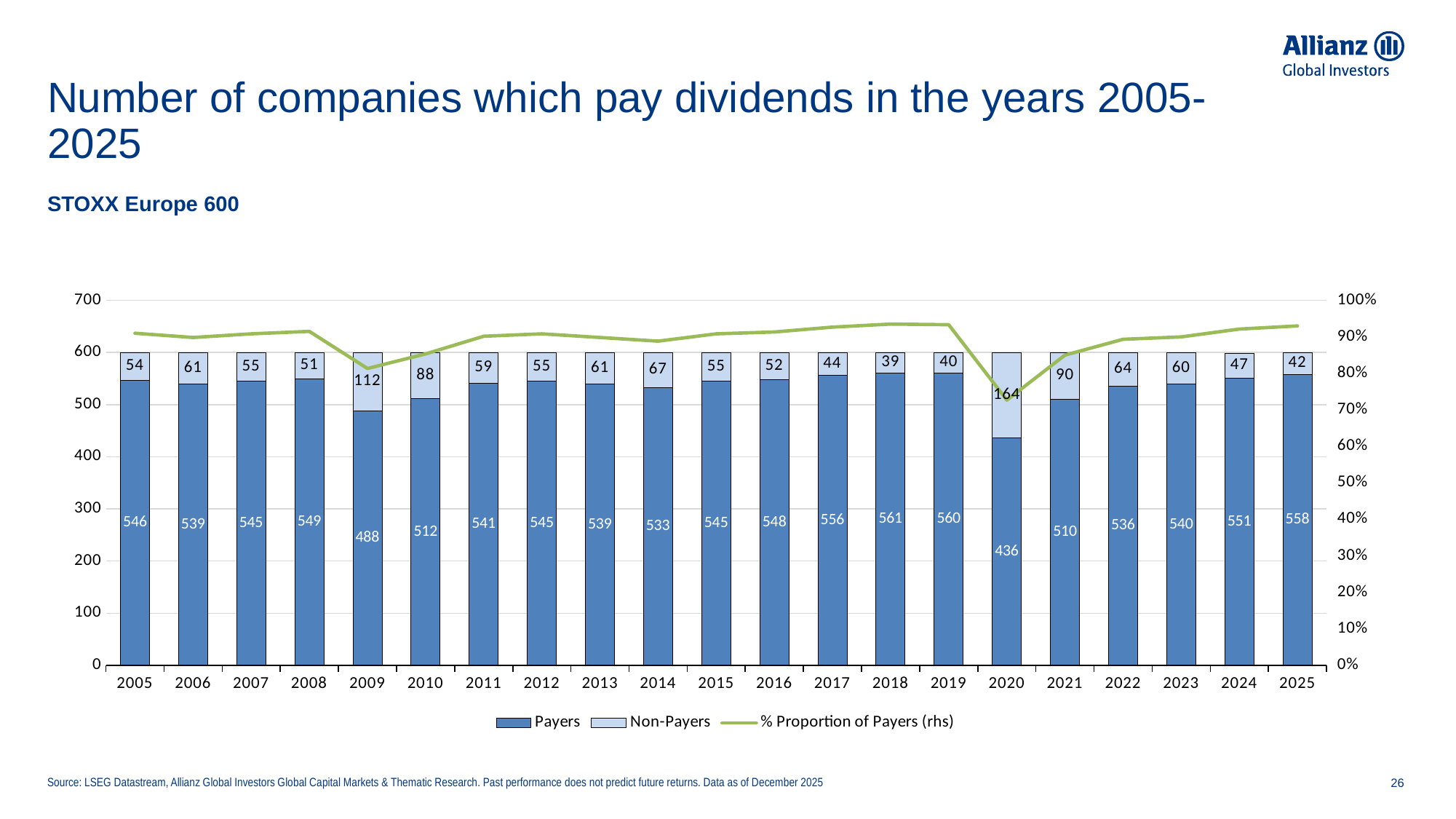
Which is larger, the Payers value for 2008 or for 2010? 2008 Which year has the highest number of Payers? 2018 Which year has the lowest number of Payers? 2020 How many series does the legend list? 3 Is the % Proportion of Payers for 2020 greater or less than 80%? less How many years are shown on the x axis? 21 Which year has the highest Non-Payers value? 2020 What is the Non-Payers value for 2009? 112 What is the total of the stacked bar for 2021 (Payers plus Non-Payers)? 600 What is the difference between the Payers values for 2019 and 2020? 124 What kind of chart is used for the Payers and Non-Payers data? Stacked bar chart How many companies were Payers in 2020? 436